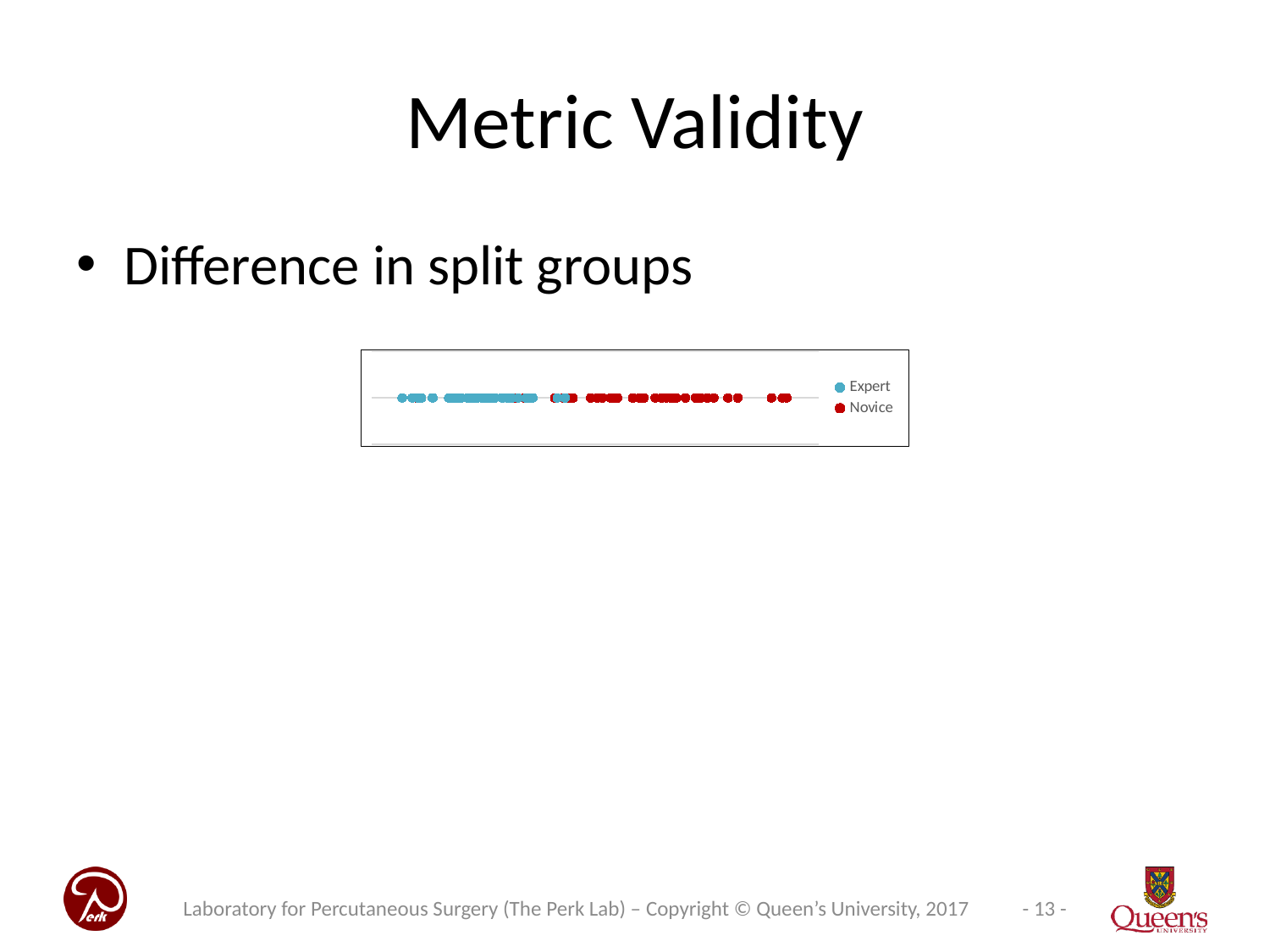
Which colour represents the Novice series in the chart? red What are the two series named in the chart legend? Expert and Novice Which series has its points positioned further to the right along the x axis, Expert or Novice? Novice Which series has its points positioned further to the left along the x axis, Expert or Novice? Expert How many series does the chart legend list? 2 What kind of chart is shown on the slide? scatter chart